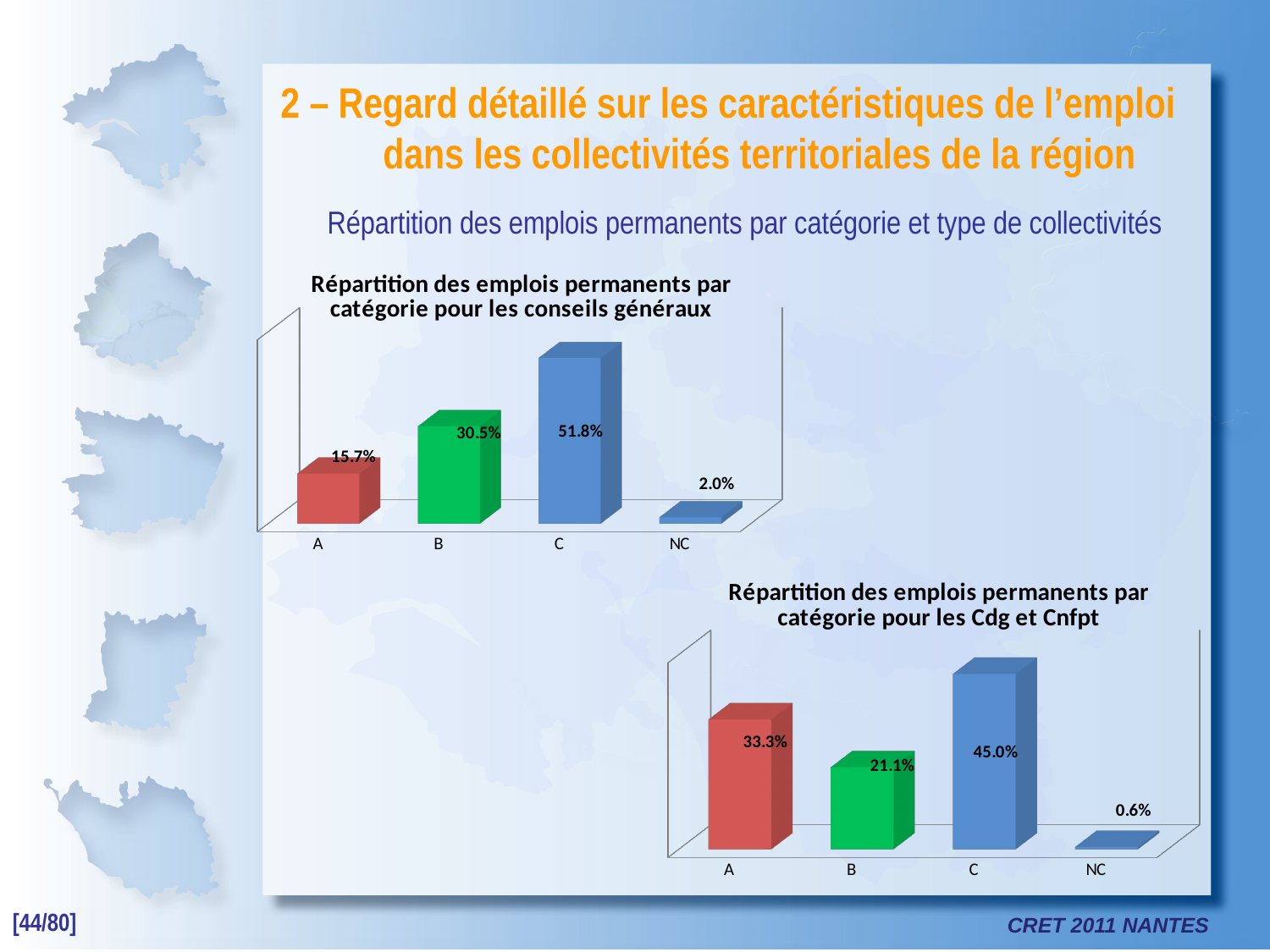
In the chart 'Répartition des emplois permanents par catégorie pour les Cdg et Cnfpt', which category has the lowest value? NC In the chart 'Répartition des emplois permanents par catégorie pour les conseils généraux', what colour is the bar for category B? Green In the chart 'Répartition des emplois permanents par catégorie pour les conseils généraux', what is the value for category A? 15.7% How many categories are shown in the chart 'Répartition des emplois permanents par catégorie pour les conseils généraux'? 4 What kind of chart is 'Répartition des emplois permanents par catégorie pour les Cdg et Cnfpt'? Bar chart In the chart 'Répartition des emplois permanents par catégorie pour les conseils généraux', what is the value for category C? 51.8% In the chart 'Répartition des emplois permanents par catégorie pour les conseils généraux', what is the difference between the values for C and B? 21.3% In the chart 'Répartition des emplois permanents par catégorie pour les conseils généraux', which category has the highest value? C In the chart 'Répartition des emplois permanents par catégorie pour les Cdg et Cnfpt', what is the value for category B? 21.1% In the chart 'Répartition des emplois permanents par catégorie pour les Cdg et Cnfpt', what is the value for NC? 0.6% In the chart 'Répartition des emplois permanents par catégorie pour les Cdg et Cnfpt', what is the difference between the values for A and B? 12.2% In the chart 'Répartition des emplois permanents par catégorie pour les Cdg et Cnfpt', which is larger, the value for A or the value for C? C